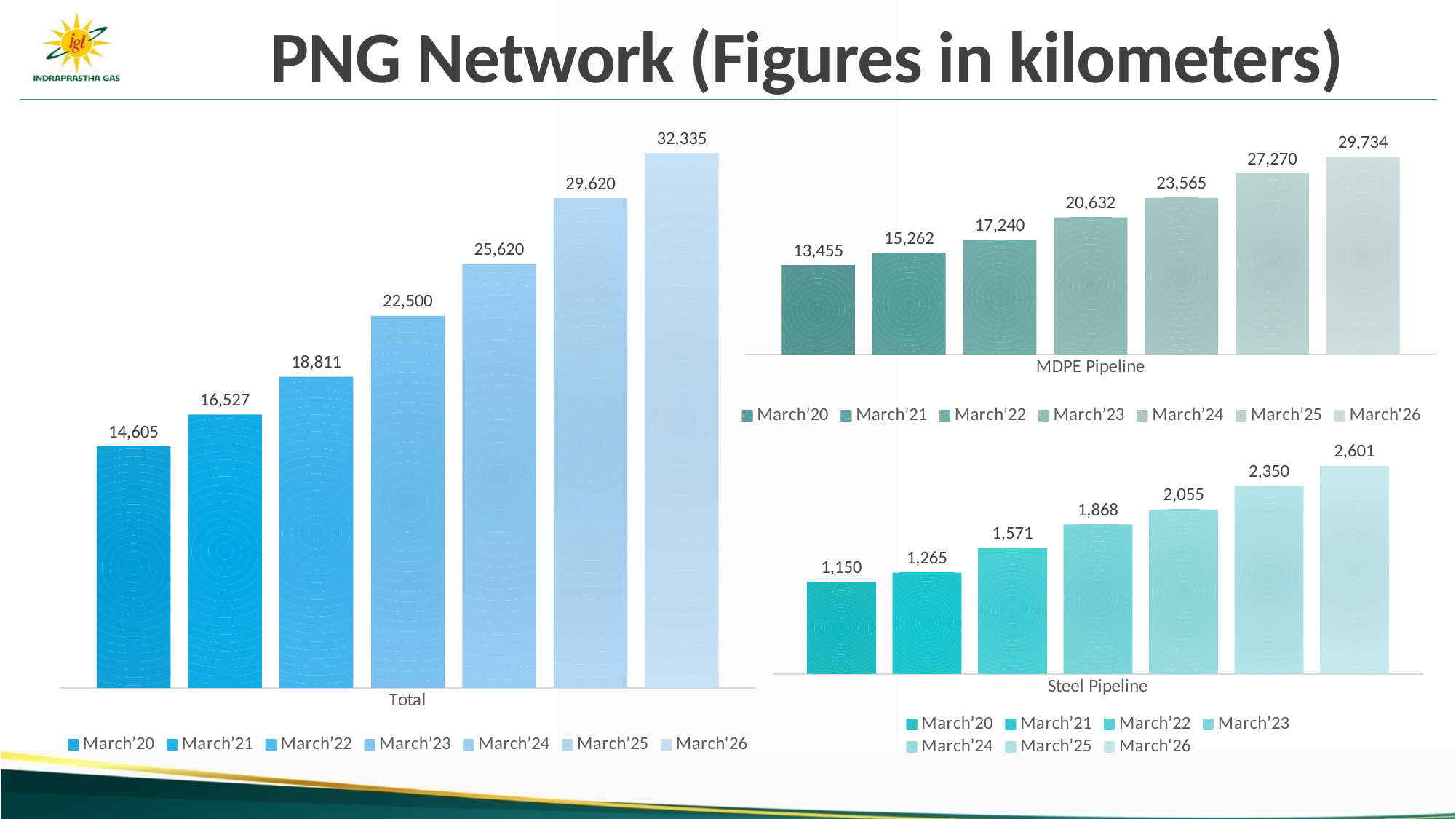
In the Total chart, what is the value for March'26? 32,335 What is the title of the slide? PNG Network (Figures in kilometers) In the Steel Pipeline chart, what is the value for March'22? 1,571 In the Steel Pipeline chart, what is the difference between the March'26 and March'25 values? 251 In the Total chart, which series has the lowest value? March'20 In the MDPE Pipeline chart, what is the value for March'23? 20,632 In the MDPE Pipeline chart, which series has the highest value? March'26 In the MDPE Pipeline chart, which is larger, the value for March'21 or the value for March'22? March'22 In the Steel Pipeline chart, do the values rise or fall from March'20 to March'26? Rise What kind of chart is the Total chart? Bar chart In the Total chart, what is the difference between the March'24 and March'23 values? 3,120 How many series does the legend of the Steel Pipeline chart list? 7